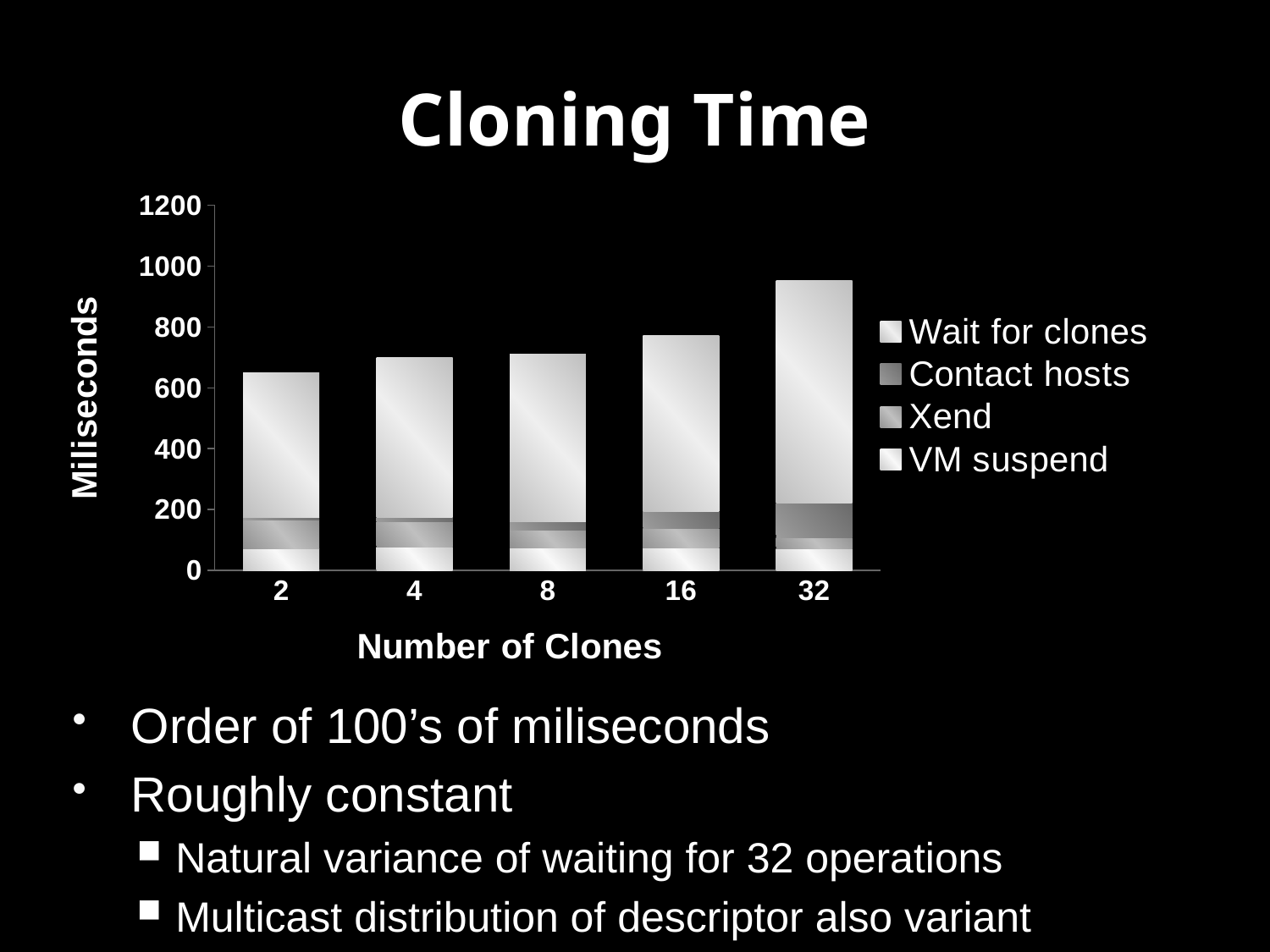
Do the total bar heights generally rise or fall as the number of clones increases? Rise Is the total bar for 4 clones greater or less than 600 milliseconds? greater Which number of clones has the lowest total bar? 2 Which has the larger total bar, 2 clones or 32 clones? 32 clones How many categories are shown on the x axis? 5 What kind of chart is shown on the slide? Stacked bar chart Which number of clones has the highest total bar? 32 What is the label on the y axis of the chart? Miliseconds How many series does the legend list? 4 Is the total bar for 32 clones greater or less than 1000 milliseconds? less Is the total bar for 2 clones greater or less than 800 milliseconds? less